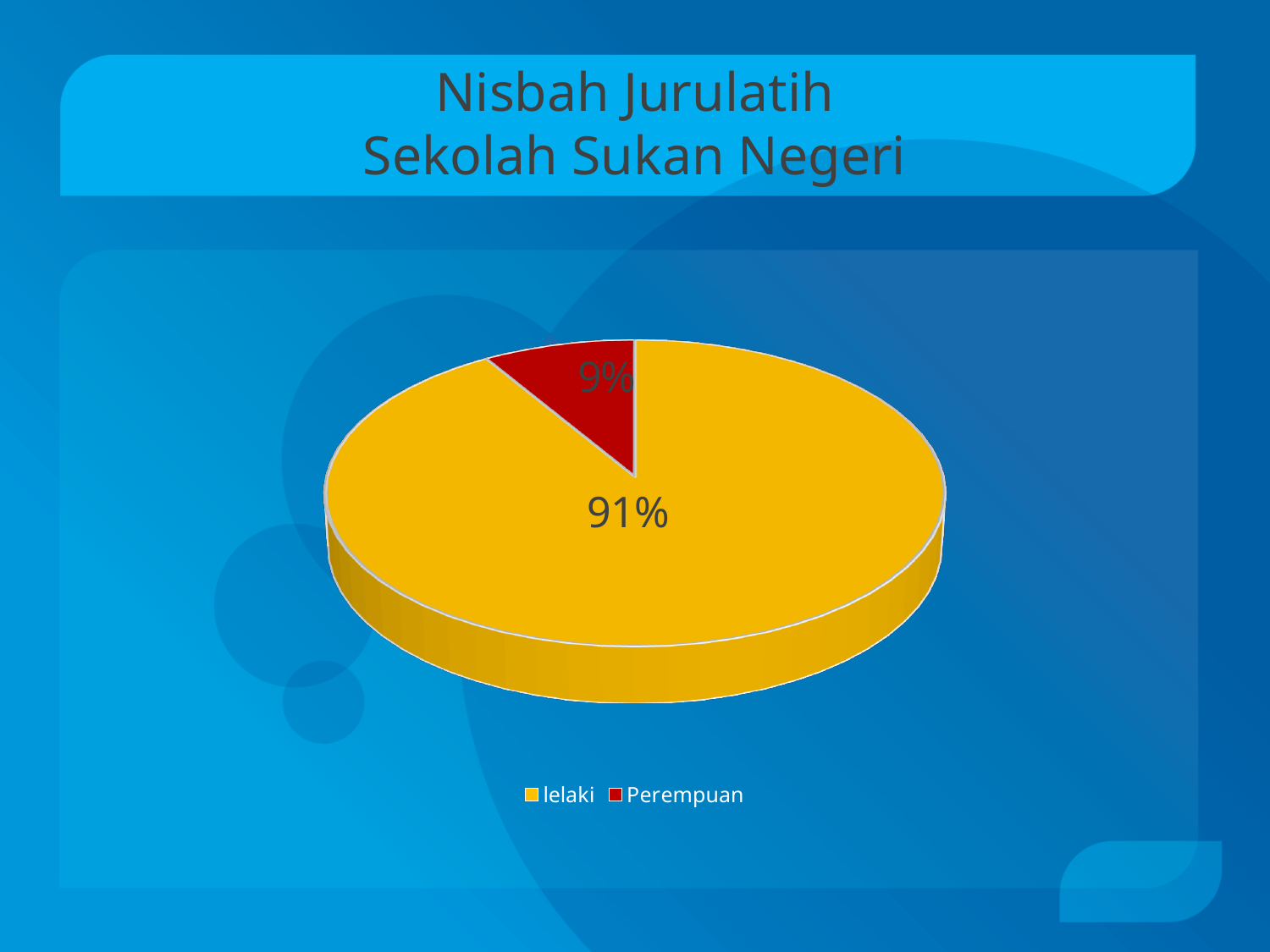
Which category has the smallest slice of the pie? Perempuan How many categories are shown in the pie chart? 2 What share of the pie does Perempuan represent? 9% What share of the pie does lelaki represent? 91% What is the title of the slide containing the chart? Nisbah Jurulatih Sekolah Sukan Negeri Which is larger, the lelaki slice or the Perempuan slice? lelaki Which category has the largest slice of the pie? lelaki What kind of chart is shown on the slide? pie chart How many entries does the legend list? 2 What colour is the Perempuan slice? red What is the difference in percentage points between the lelaki and Perempuan slices? 82